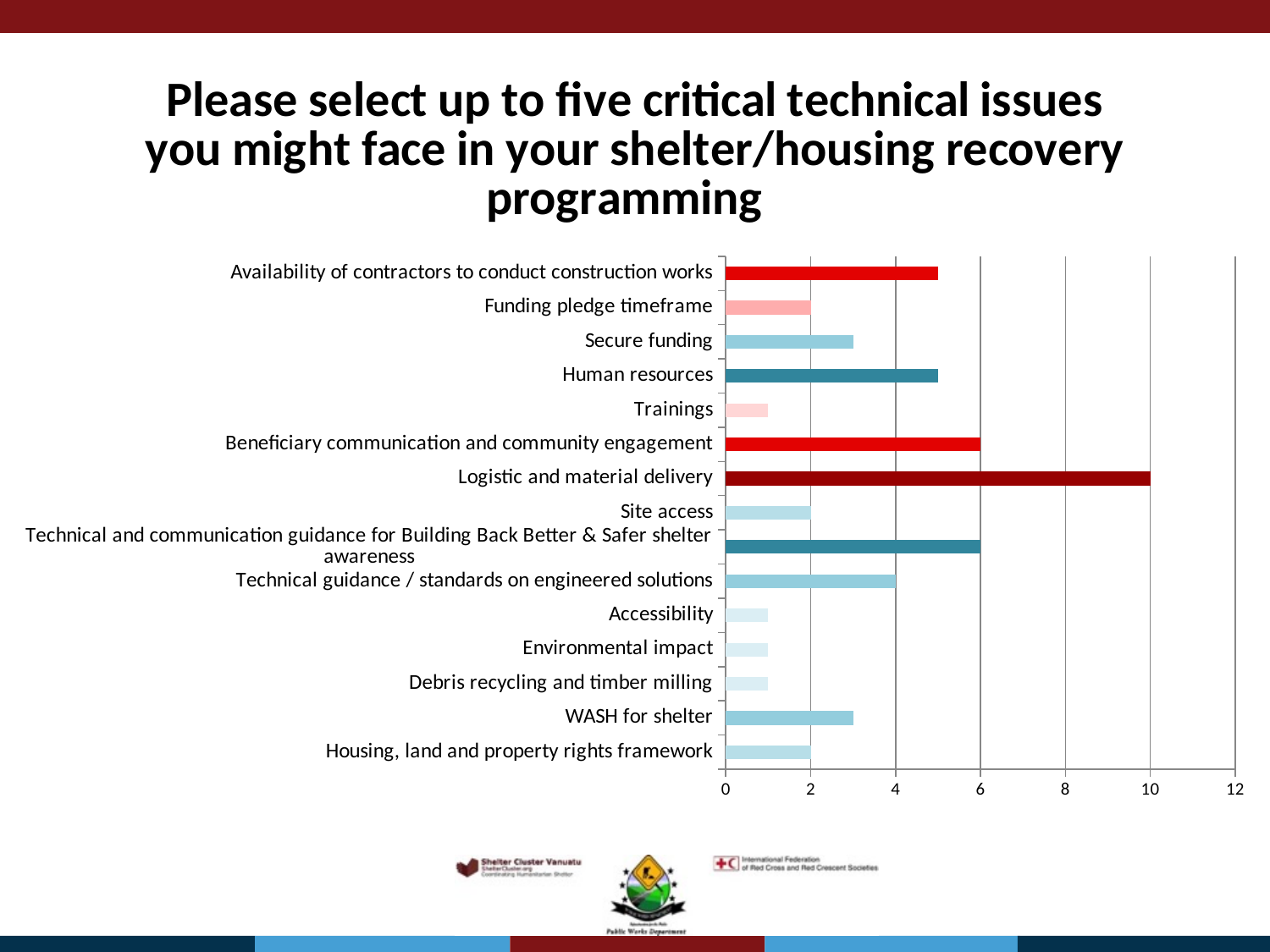
What is the title of the slide? Please select up to five critical technical issues you might face in your shelter/housing recovery programming Is the value for Trainings greater or less than 2? less What is the value for Site access? 2 What is the value for Logistic and material delivery? 10 Is the value for Availability of contractors to conduct construction works greater or less than 4? greater What is the value for Beneficiary communication and community engagement? 6 What is the value for Technical guidance / standards on engineered solutions? 4 What kind of chart is shown on the slide? bar chart How many categories are shown in the chart? 15 Which is larger, the value for Logistic and material delivery or the value for Beneficiary communication and community engagement? Logistic and material delivery Which category has the highest value? Logistic and material delivery What is the difference between the values for Logistic and material delivery and Site access? 8